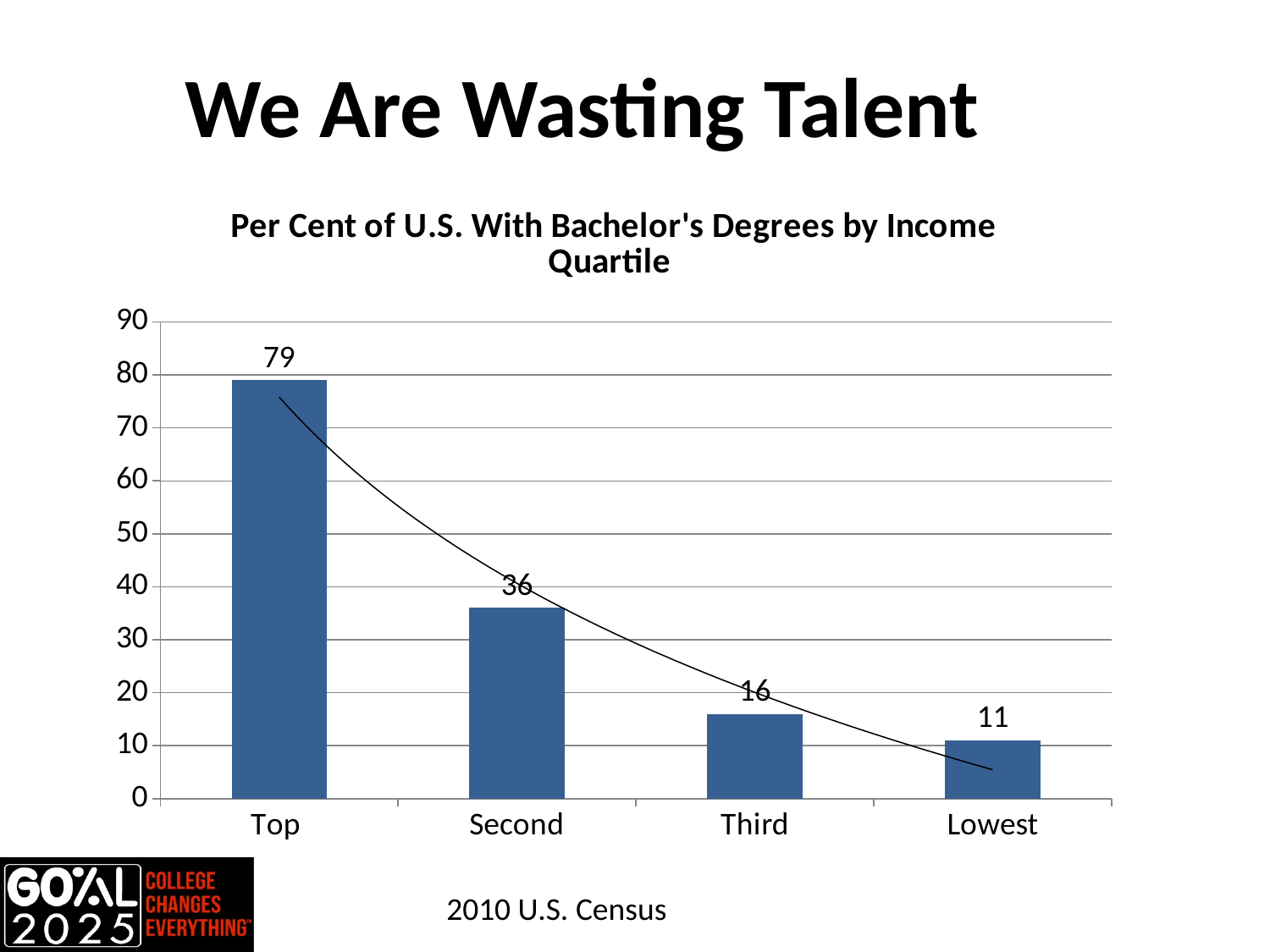
Which is larger, the value for Second or the value for Third? Second What is the value for the Third income quartile? 16 How many income quartile categories are shown on the chart? 4 What is the value for the Top income quartile? 79 What is the value for the Lowest income quartile? 11 What is the difference between the values for the Top and Second quartiles? 43 Which income quartile has the highest per cent with bachelor's degrees? Top Do the values rise or fall moving from Top to Lowest along the x axis? Fall What is the value for the Second income quartile? 36 Which income quartile has the lowest per cent with bachelor's degrees? Lowest What kind of chart is shown on the slide? Bar chart What is the difference between the values for the Third and Lowest quartiles? 5